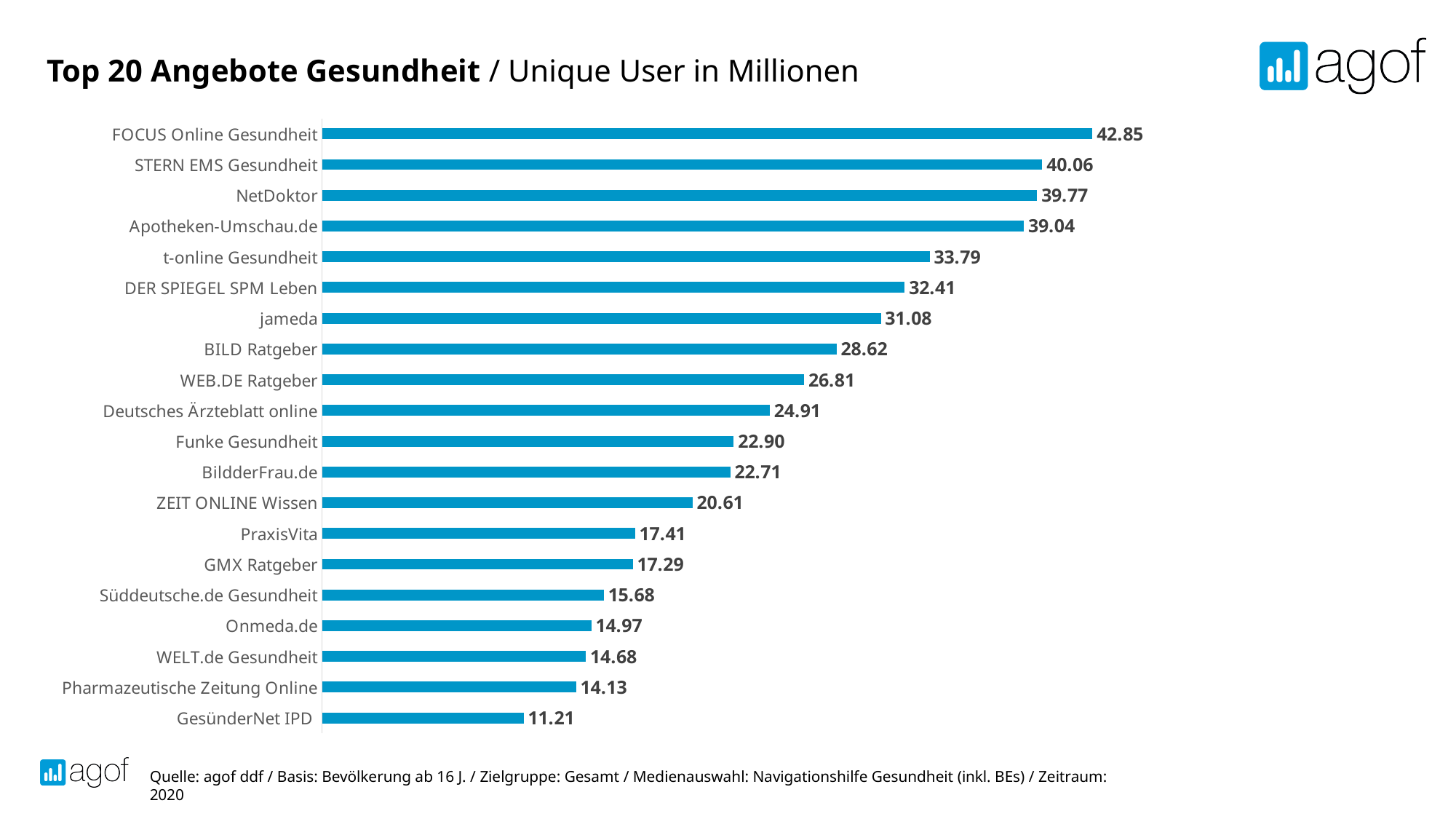
Which is larger, the value for ZEIT ONLINE Wissen or the value for PraxisVita? ZEIT ONLINE Wissen Which category has the highest value? FOCUS Online Gesundheit Which is larger, the value for t-online Gesundheit or the value for DER SPIEGEL SPM Leben? t-online Gesundheit Which category has the lowest value? GesünderNet IPD What is the title of the chart? Top 20 Angebote Gesundheit / Unique User in Millionen What is the value for NetDoktor? 39.77 What is the difference between the values for BILD Ratgeber and WEB.DE Ratgeber? 1.81 What is the difference between the values for FOCUS Online Gesundheit and STERN EMS Gesundheit? 2.79 What kind of chart is shown on the slide? Bar chart What is the value for jameda? 31.08 How many categories are shown in the chart? 20 What is the value for Onmeda.de? 14.97